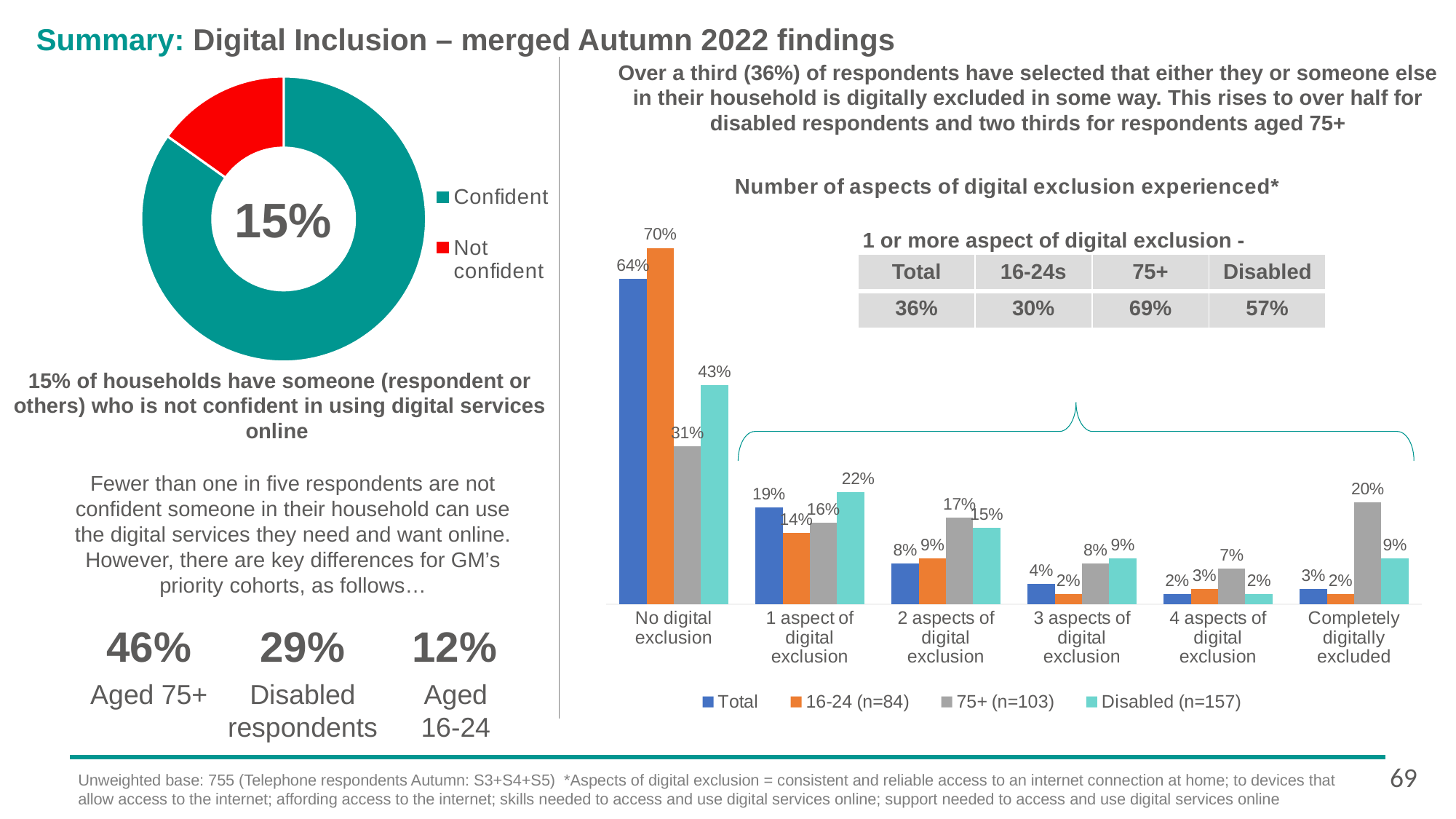
In the 'Number of aspects of digital exclusion experienced' chart, what is the value for 75+ (n=103) in the 'Completely digitally excluded' category? 20% In the 'Number of aspects of digital exclusion experienced' chart, which series has the lowest value for 'No digital exclusion'? 75+ (n=103) What kind of chart is the 'Number of aspects of digital exclusion experienced' chart? Bar chart In the 'Number of aspects of digital exclusion experienced' chart, which is larger for '2 aspects of digital exclusion': the 75+ (n=103) value or the Disabled (n=157) value? 75+ (n=103) In the 'Number of aspects of digital exclusion experienced' chart, what is the Total value for 'No digital exclusion'? 64% How many categories are shown on the x axis of the 'Number of aspects of digital exclusion experienced' chart? 6 In the donut chart on the left of the slide, what value is shown for the 'Not confident' slice? 15% In the 'Number of aspects of digital exclusion experienced' chart, what is the difference between the 16-24 (n=84) and 75+ (n=103) values for 'No digital exclusion'? 39% In the 'Number of aspects of digital exclusion experienced' chart, what is the value for Disabled (n=157) in the '1 aspect of digital exclusion' category? 22% How many series does the legend of the 'Number of aspects of digital exclusion experienced' chart list? 4 In the 'Number of aspects of digital exclusion experienced' chart, which series has the highest value for 'No digital exclusion'? 16-24 (n=84) What kind of chart is the chart on the left of the slide showing 'Confident' and 'Not confident'? Donut chart